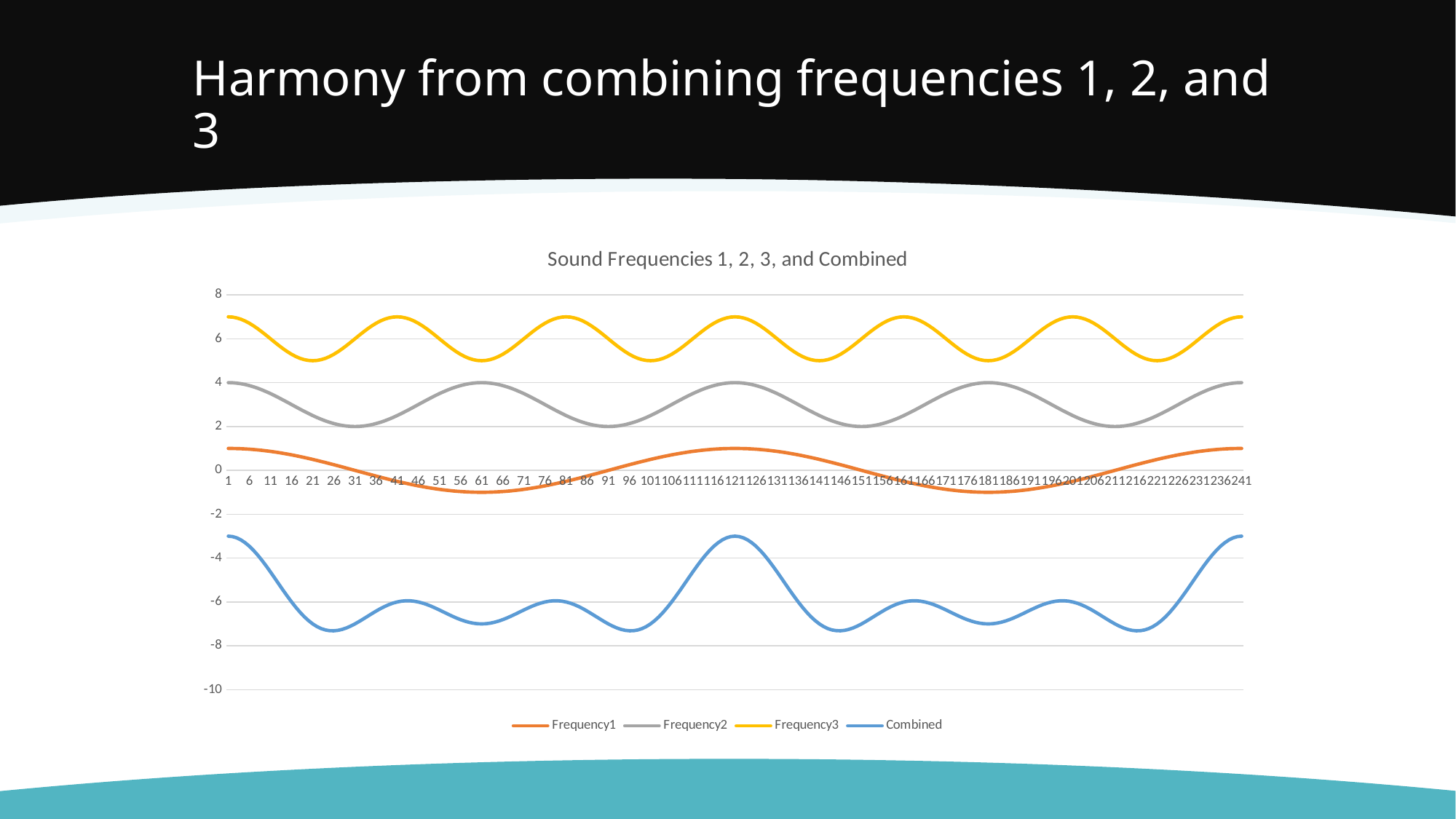
How many series does the legend list? 4 Which colour is used for the Combined series? blue What kind of chart is shown on the slide? line chart Is the value of the Combined series at x = 121 greater or less than -4? greater Is the lowest value of the Frequency3 series greater or less than 4? greater Is the value of Frequency1 at x = 1 greater or less than 0? greater Which series has larger values, Frequency2 or Frequency1? Frequency2 What is the title of the chart? Sound Frequencies 1, 2, 3, and Combined Which series has the highest values on the chart? Frequency3 Which series has the lowest values on the chart? Combined